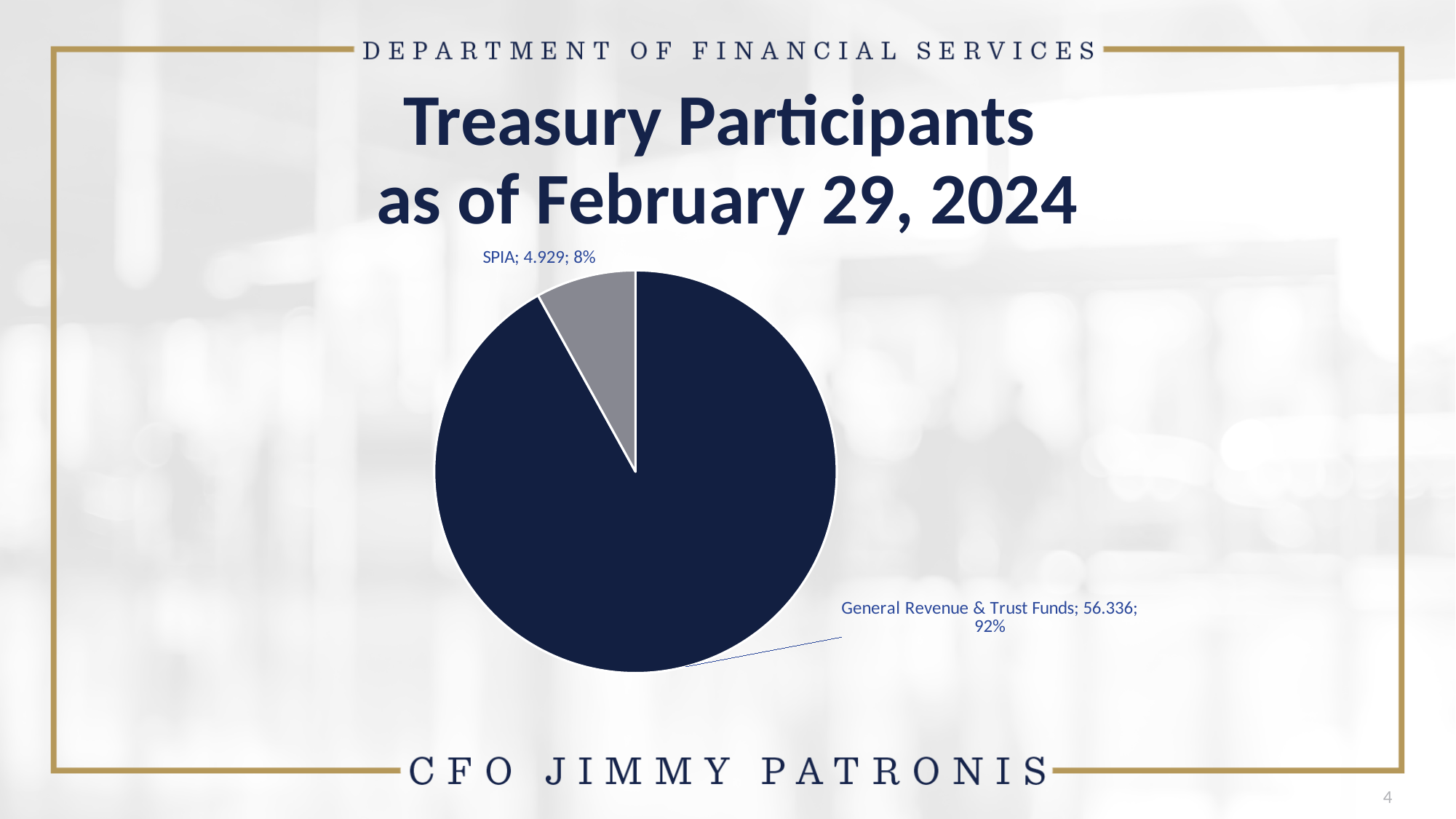
What is the title of the slide containing the chart? Treasury Participants as of February 29, 2024 What is the difference between the values for General Revenue & Trust Funds and SPIA? 51.407 Which category has the smallest slice of the pie? SPIA Which is larger, the value for SPIA or the value for General Revenue & Trust Funds? General Revenue & Trust Funds Which category has the largest slice of the pie? General Revenue & Trust Funds How many slices does the pie chart have? 2 What percentage share of the pie does SPIA represent? 8% What percentage share of the pie does General Revenue & Trust Funds represent? 92% What is the value for SPIA? 4.929 What is the value for General Revenue & Trust Funds? 56.336 What colour is the SPIA slice? Gray What type of chart is shown on the slide? Pie chart